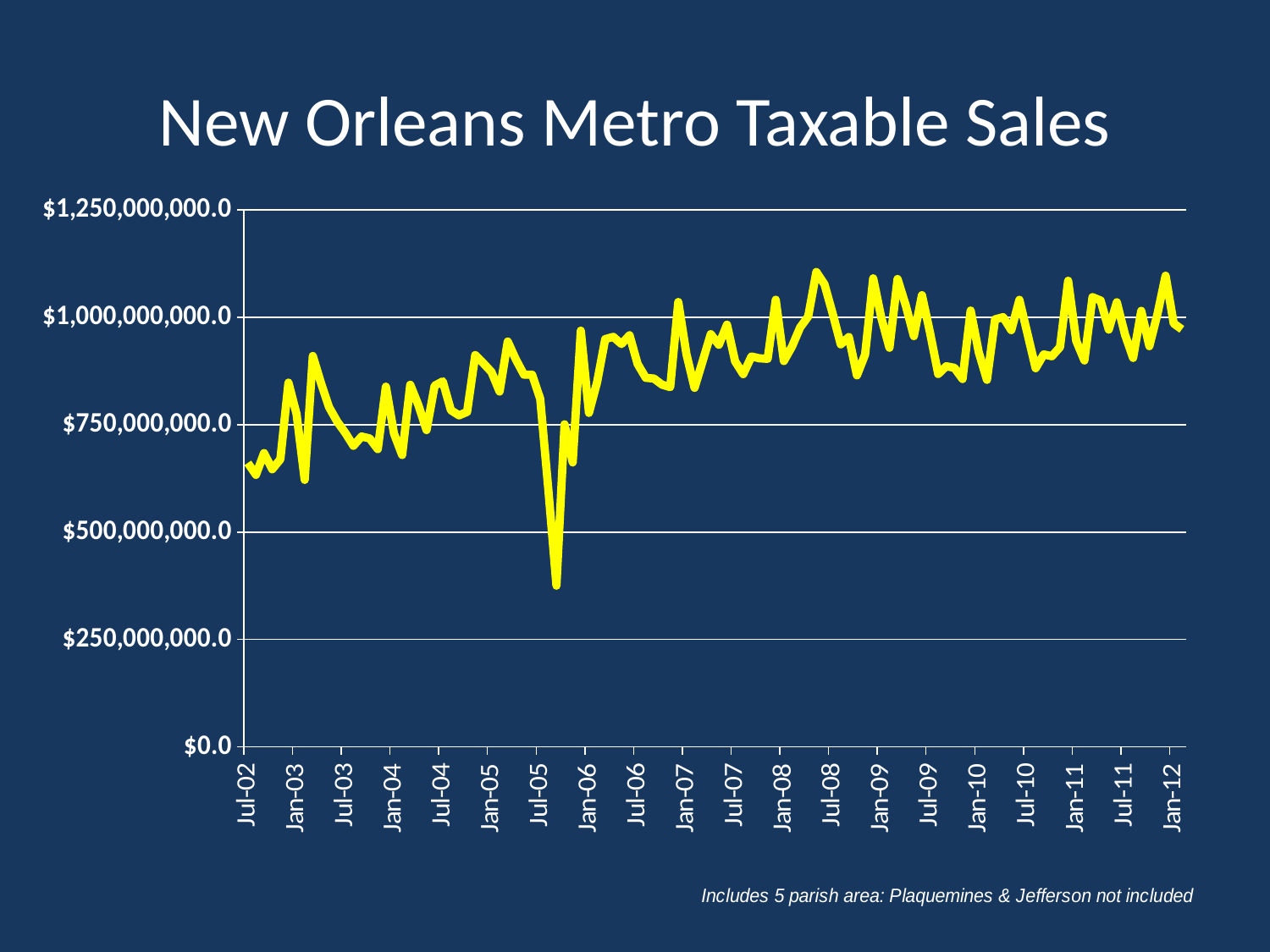
Which is larger, the value for Jul-02 or the value for Jul-08? Jul-08 Is the lowest point on the line, in late 2005, greater or less than $500,000,000.0? less Overall, do taxable sales rise or fall from Jul-02 to Jan-12? Rise Is the value for Jan-10 greater or less than $1,000,000,000.0? less Is the value for Jan-05 greater or less than $750,000,000.0? greater What is the title of the chart? New Orleans Metro Taxable Sales What colour is the line plotted on the chart? Yellow How many date labels are shown on the x axis? 20 What kind of chart is shown on the slide? Line chart